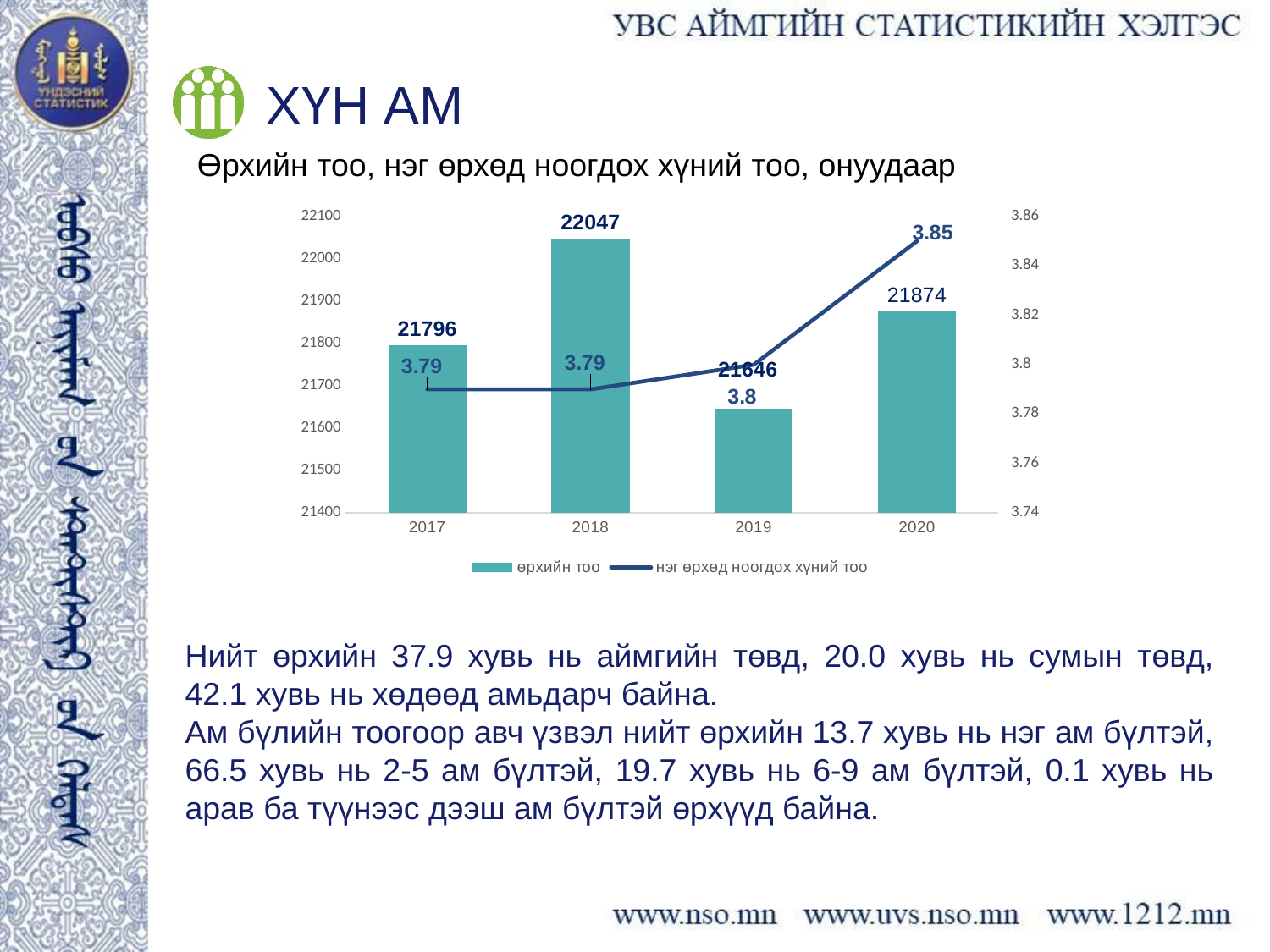
Which year has the highest number of households (өрхийн тоо)? 2018 What is the value of persons per household (нэг өрхөд ноогдох хүний тоо) in 2019? 3.8 What is the difference in the number of households between 2018 and 2019? 401 What is the value of persons per household (нэг өрхөд ноогдох хүний тоо) in 2020? 3.85 How many series does the chart legend list? 2 What is the title of the chart? Өрхийн тоо, нэг өрхөд ноогдох хүний тоо, онуудаар Does the persons-per-household line (нэг өрхөд ноогдох хүний тоо) rise or fall from 2019 to 2020? rise Which year has more households, 2017 or 2020? 2020 How many years are shown on the x axis of the chart? 4 What is the number of households (өрхийн тоо) in 2020? 21874 What is the number of households (өрхийн тоо) in 2018? 22047 Which year has the lowest number of households (өрхийн тоо)? 2019